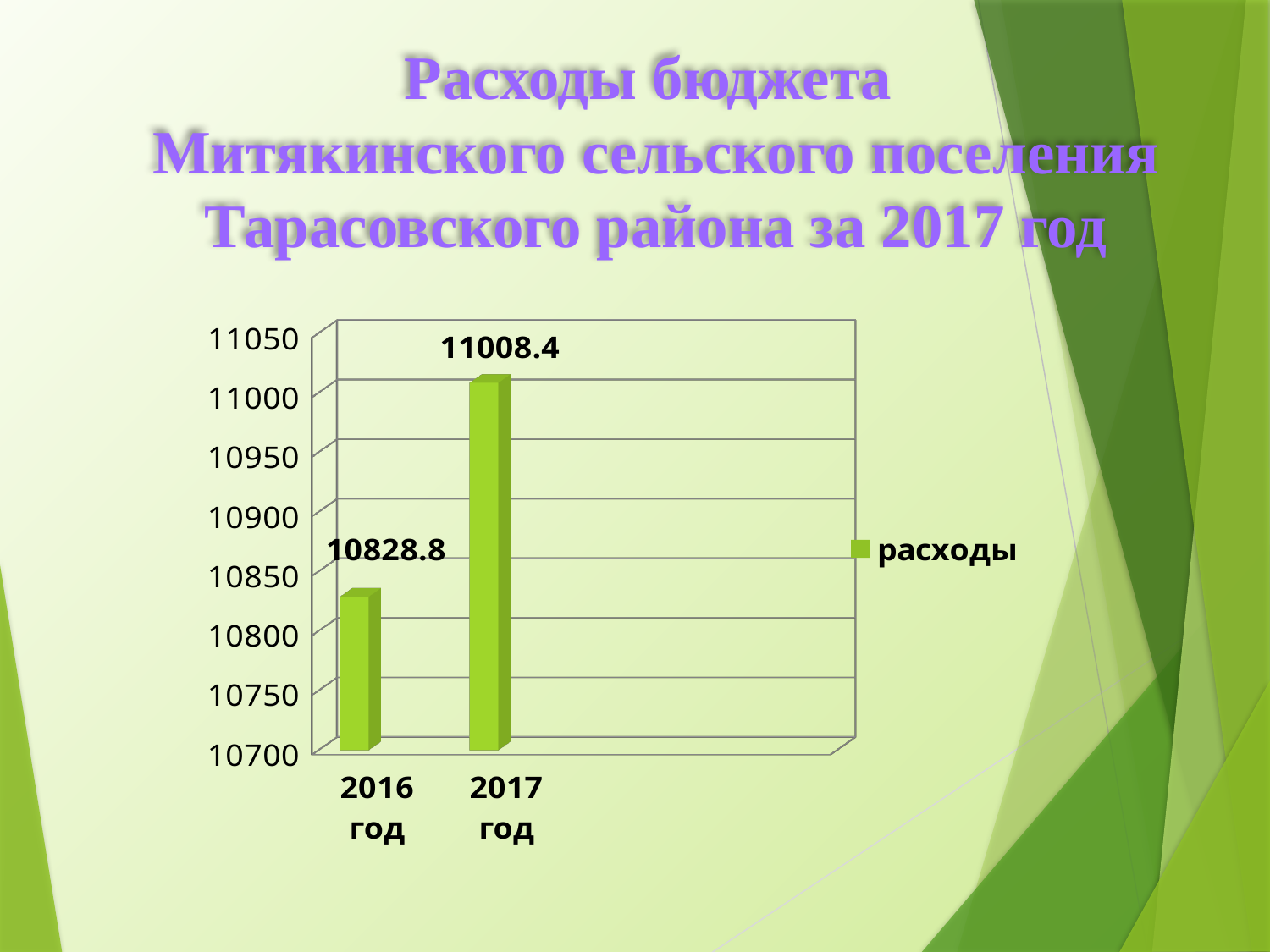
Which is larger, the value for 2016 год or 2017 год? 2017 год Which year has the lowest value? 2016 год What kind of chart is shown on the slide? bar chart What is the name of the series in the legend? расходы What is the difference between the values for 2017 год and 2016 год? 179.6 What is the value for 2017 год? 11008.4 How many series does the legend list? 1 Is the value for 2016 год greater or less than 10850? less How many categories are shown on the x axis? 2 Which year has the highest value? 2017 год What is the value for 2016 год? 10828.8 Is the value for 2017 год greater or less than 11000? greater